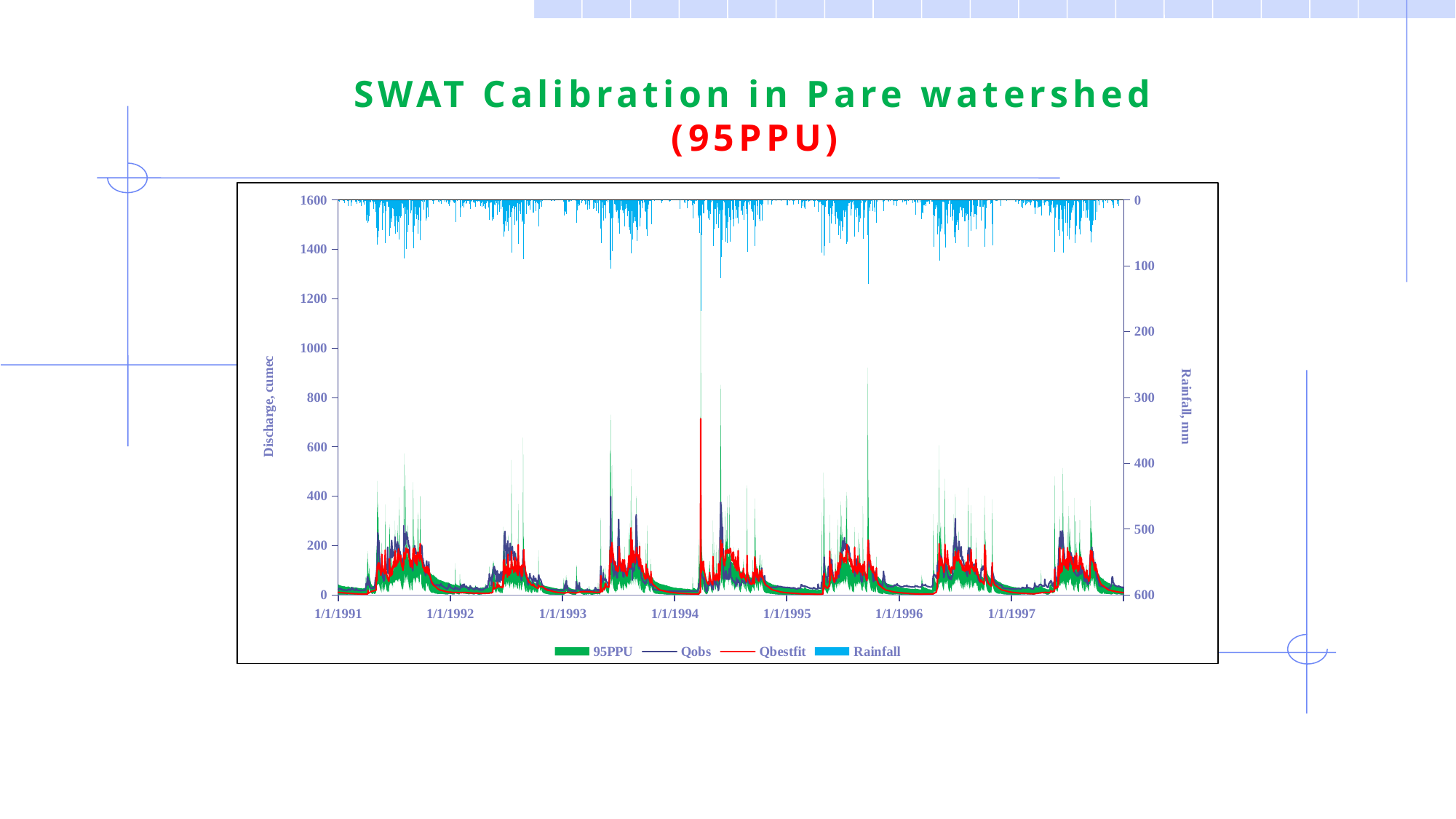
Is the highest peak of the Qbestfit (red) line, which occurs shortly after 1/1/1994, greater or less than 600 cumec? greater What is the label of the left vertical axis of the chart? Discharge, cumec How many series does the chart legend list? 4 Which series is drawn in red on the chart? Qbestfit What is the last date label on the x axis of the chart? 1/1/1997 What is the highest tick value shown on the left (Discharge) axis? 1600 What is the first date label on the x axis of the chart? 1/1/1991 What is the highest tick value shown on the right (Rainfall) axis? 600 What is the label of the right vertical axis of the chart? Rainfall, mm How many date labels are shown along the x axis? 7 In which year does the Qbestfit (red) line reach its highest peak? 1994